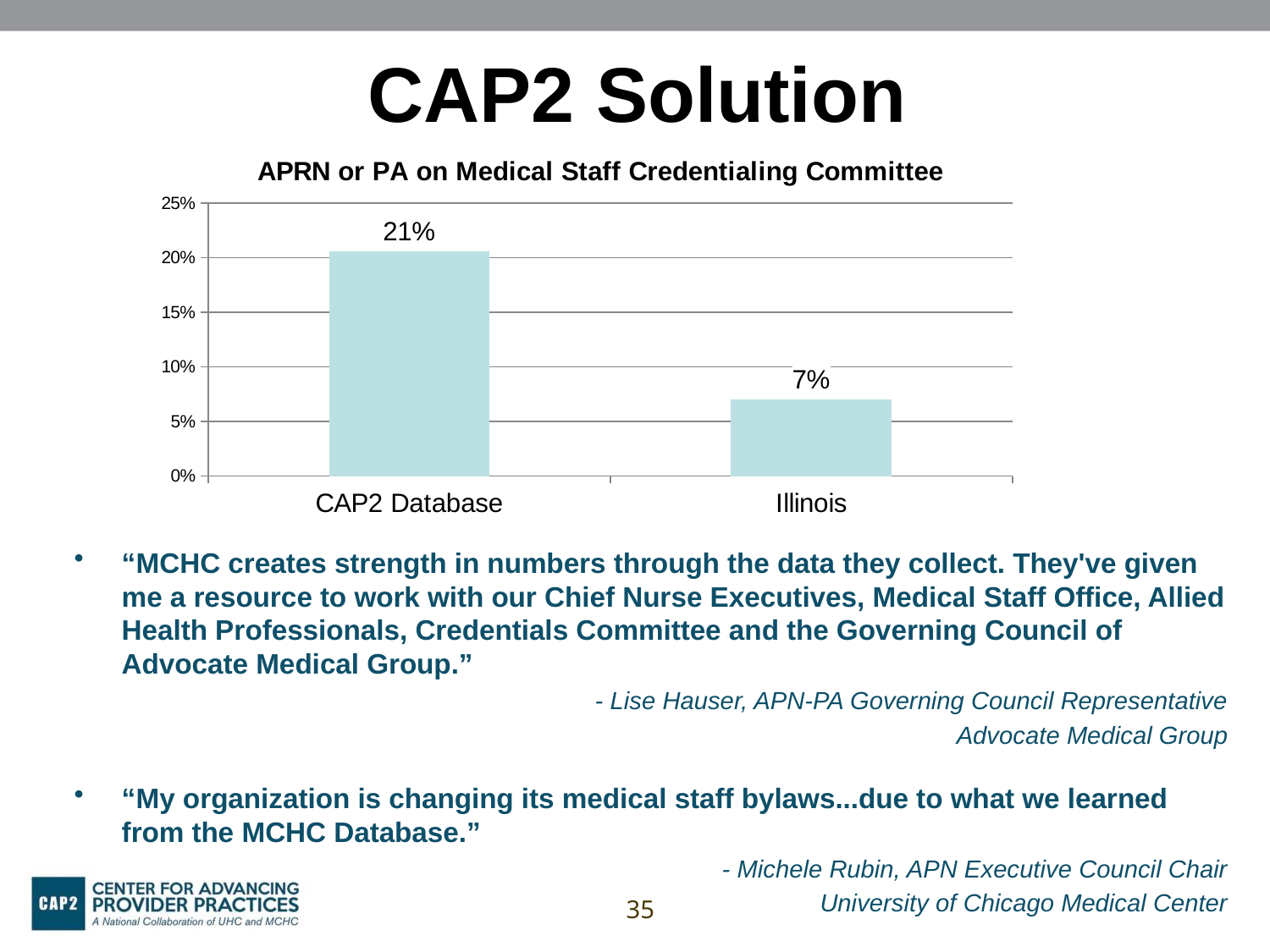
Is the value for CAP2 Database greater or less than 20%? greater What is the title of the chart? APRN or PA on Medical Staff Credentialing Committee Which category has the highest value? CAP2 Database What is the maximum value shown on the vertical axis of the chart? 25% What is the difference between the CAP2 Database value and the Illinois value? 14% Which category has the lowest value? Illinois Is the value for Illinois greater or less than 10%? less How many categories are shown on the chart? 2 What is the value for CAP2 Database? 21% What kind of chart is shown on the slide? bar chart Which is larger, the value for CAP2 Database or the value for Illinois? CAP2 Database What is the value for Illinois? 7%